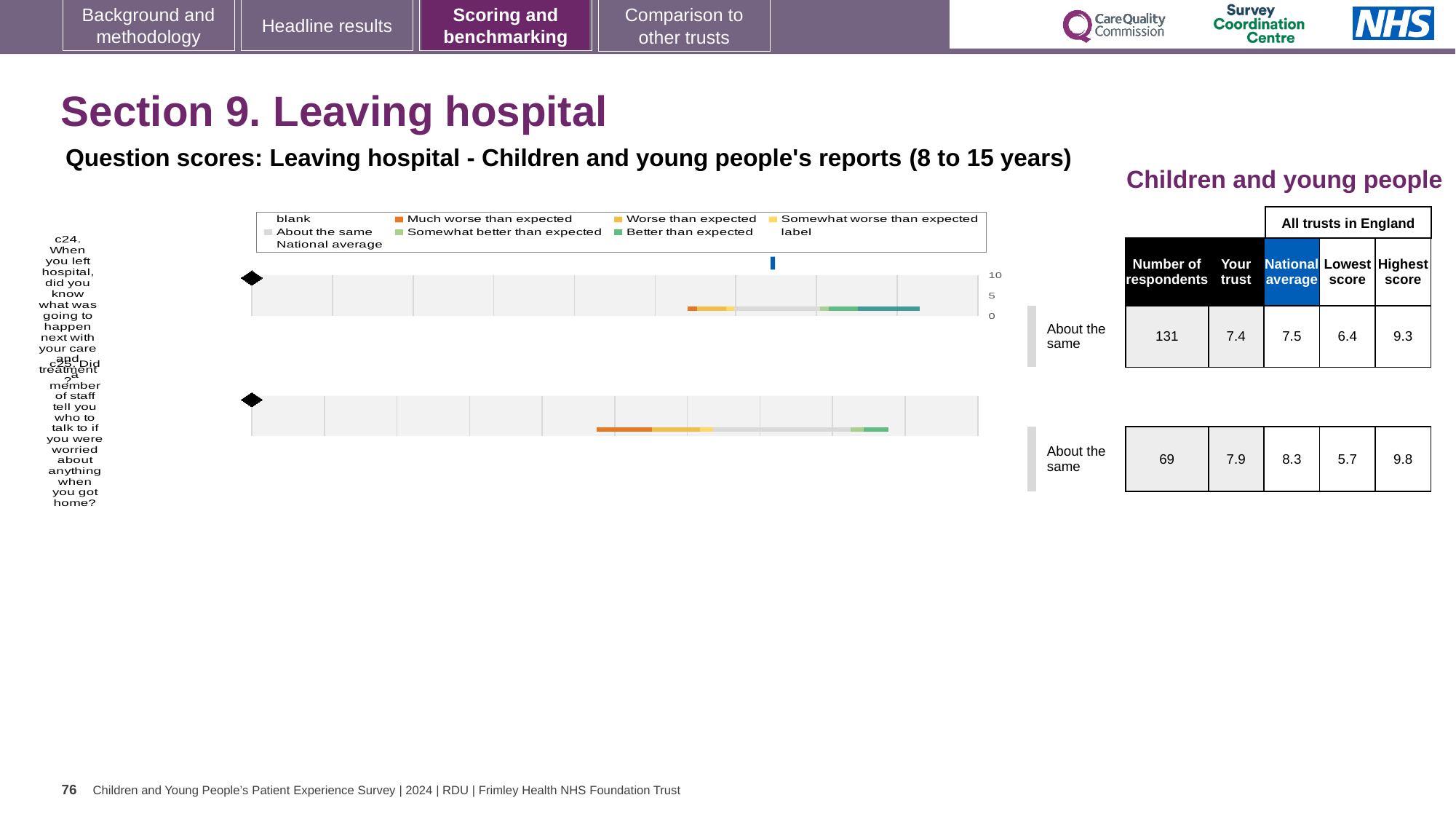
How many survey questions are plotted in the chart? 2 What colour does the legend use for 'Much worse than expected'? orange What is the 'Your trust' score for question c24? 7.4 What is the national average score for question c25? 8.3 Which question has the higher 'Highest score' value, c24 or c25? c25 For question c25, how much higher is the national average than the 'Your trust' score? 0.4 What kind of chart is used to show the question scores on this slide? bar chart Which question has the higher 'Your trust' score, c24 or c25? c25 What is the difference between the highest score and the lowest score for question c24? 2.9 In the chart legend, which entry is represented by the blue marker? National average What is the lowest score among all trusts in England for question c25? 5.7 How many respondents answered question c24? 131